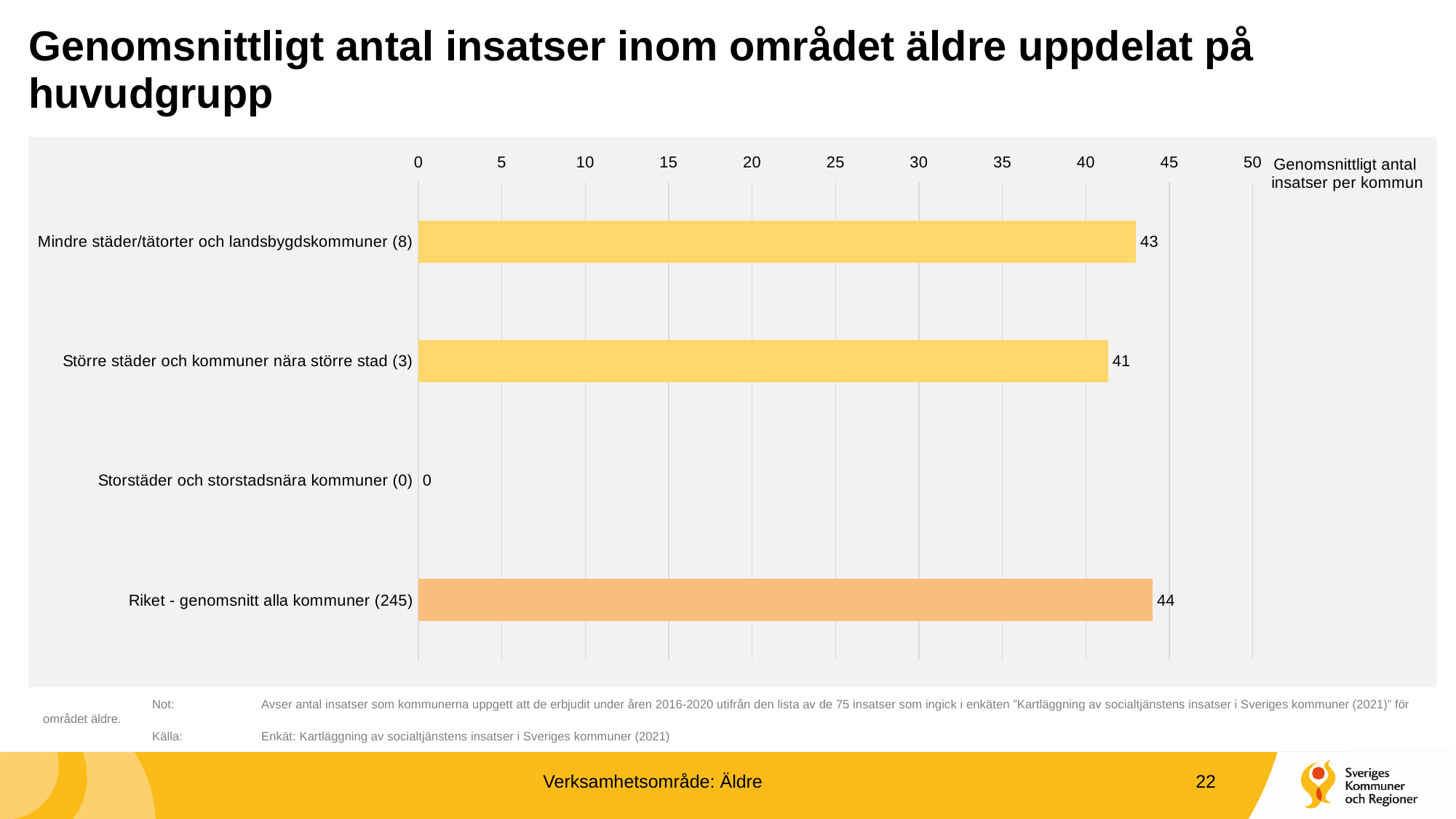
Which category has the lowest value? Storstäder och storstadsnära kommuner (0) What is the value for Storstäder och storstadsnära kommuner (0)? 0 Is the value for Större städer och kommuner nära större stad (3) greater or less than 45? less What is the value for Riket - genomsnitt alla kommuner (245)? 44 What kind of chart is shown on the slide? bar chart Which is larger: the value for Mindre städer/tätorter och landsbygdskommuner (8) or for Större städer och kommuner nära större stad (3)? Mindre städer/tätorter och landsbygdskommuner (8) Which category has the highest value? Riket - genomsnitt alla kommuner (245) What is the value for Mindre städer/tätorter och landsbygdskommuner (8)? 43 What is the label of the value axis at the top of the chart? Genomsnittligt antal insatser per kommun What is the value for Större städer och kommuner nära större stad (3)? 41 What is the difference between the values for Riket - genomsnitt alla kommuner (245) and Större städer och kommuner nära större stad (3)? 3 How many categories are shown in the chart? 4